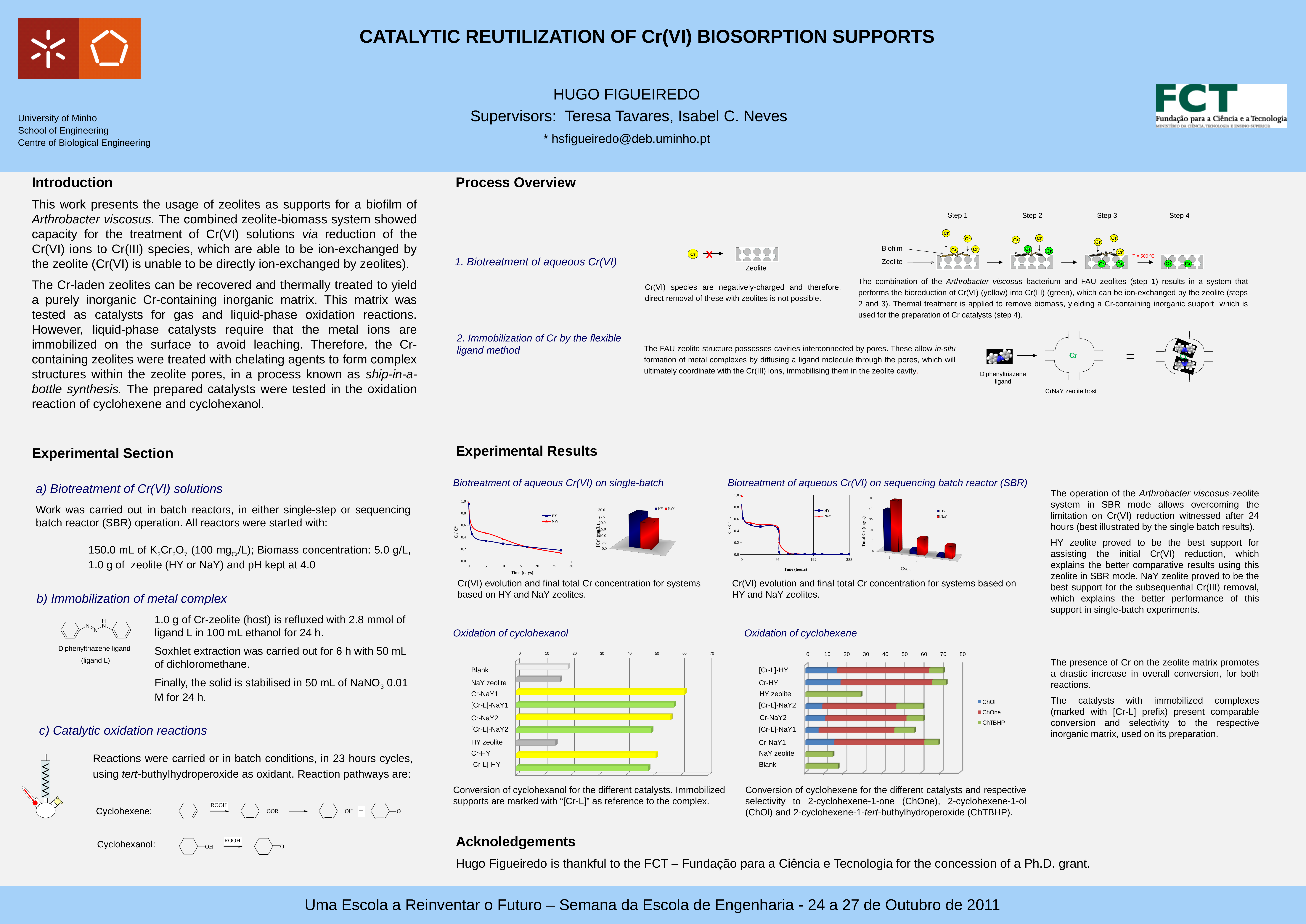
How many series does the legend of the 'Oxidation of cyclohexene' chart list? 3 In the 'Oxidation of cyclohexanol' chart, which catalyst has the highest conversion? Cr-NaY1 In the 'Oxidation of cyclohexanol' chart, is the value for Blank greater or less than 30? less In the 'Oxidation of cyclohexene' chart, is the total value for Cr-HY greater or less than 60? greater In the 'Oxidation of cyclohexanol' chart, which has the larger conversion, Cr-NaY2 or HY zeolite? Cr-NaY2 In the 'Biotreatment of aqueous Cr(VI) on single-batch' line chart, do the C/C° values rise or fall over time? Fall In the 'Oxidation of cyclohexanol' chart, how many catalysts (categories) are plotted? 9 In the 'Oxidation of cyclohexene' chart, is the total value for Blank greater or less than 20? less In the 'Biotreatment of aqueous Cr(VI) on single-batch' line chart, how many series does the legend list? 2 What kind of chart is the 'Oxidation of cyclohexanol' chart? Bar chart What are the legend entries of the 'Oxidation of cyclohexene' chart? ChOl, ChOne, ChTBHP